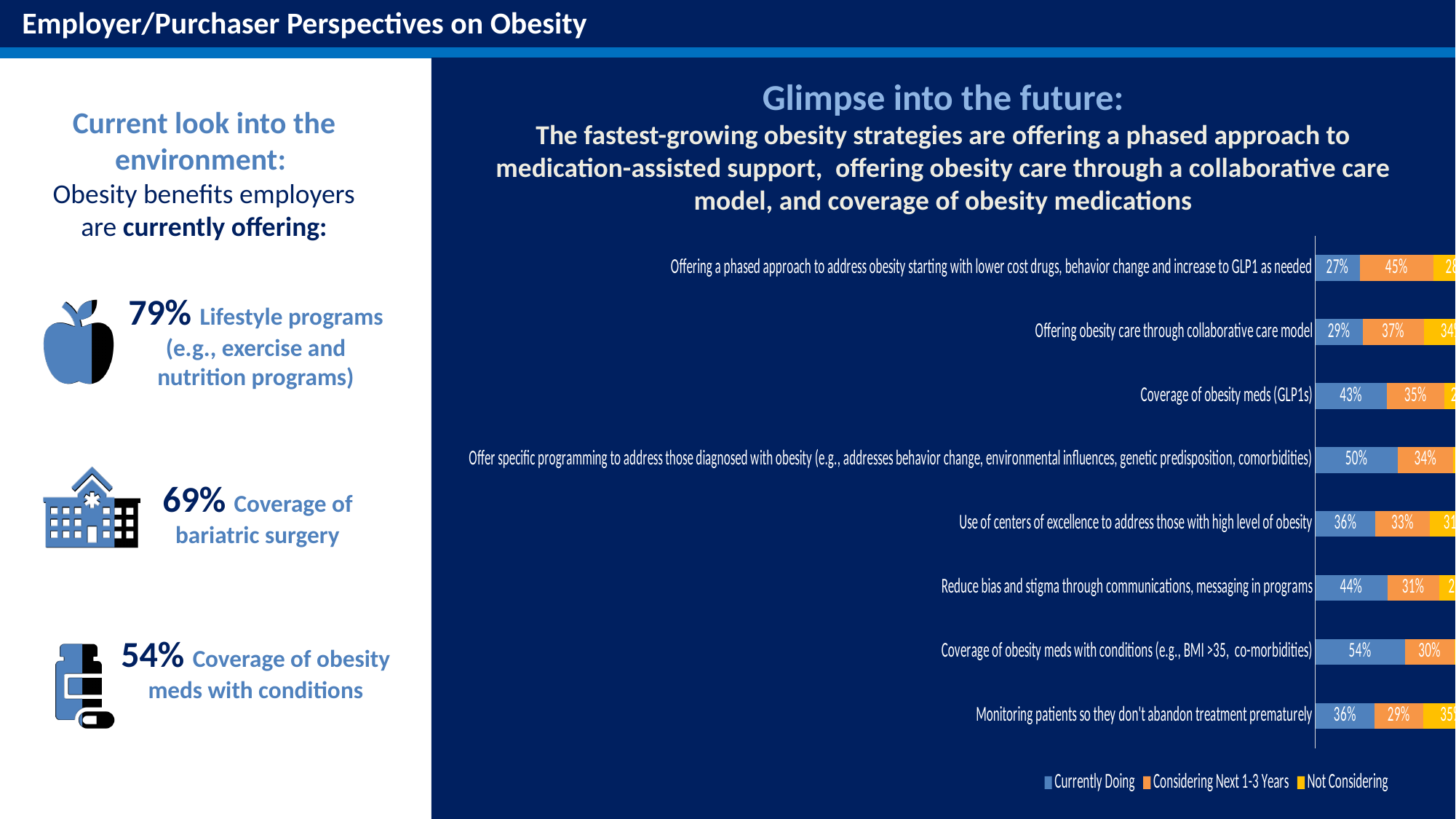
What kind of chart is shown on the slide? Stacked bar chart What is the 'Currently Doing' value for 'Reduce bias and stigma through communications, messaging in programs'? 44% What is the difference in percentage points between the 'Currently Doing' values for 'Coverage of obesity meds with conditions' and 'Offering a phased approach to address obesity'? 27 percentage points What are the three legend entries of the chart? Currently Doing, Considering Next 1-3 Years, Not Considering How many series does the chart legend list? 3 What is the 'Considering Next 1-3 Years' value for 'Offering a phased approach to address obesity starting with lower cost drugs, behavior change and increase to GLP1 as needed'? 45% Which strategy has the lowest 'Considering Next 1-3 Years' value? Monitoring patients so they don't abandon treatment prematurely Which strategy has the lowest 'Currently Doing' value? Offering a phased approach to address obesity starting with lower cost drugs, behavior change and increase to GLP1 as needed How many strategies (categories) are plotted in the chart? 8 Which strategy has the highest 'Currently Doing' value? Coverage of obesity meds with conditions (e.g., BMI >35, co-morbidities) Which is larger: the 'Currently Doing' value for 'Offer specific programming to address those diagnosed with obesity' or for 'Use of centers of excellence to address those with high level of obesity'? Offer specific programming to address those diagnosed with obesity What is the 'Currently Doing' value for 'Coverage of obesity meds (GLP1s)'? 43%